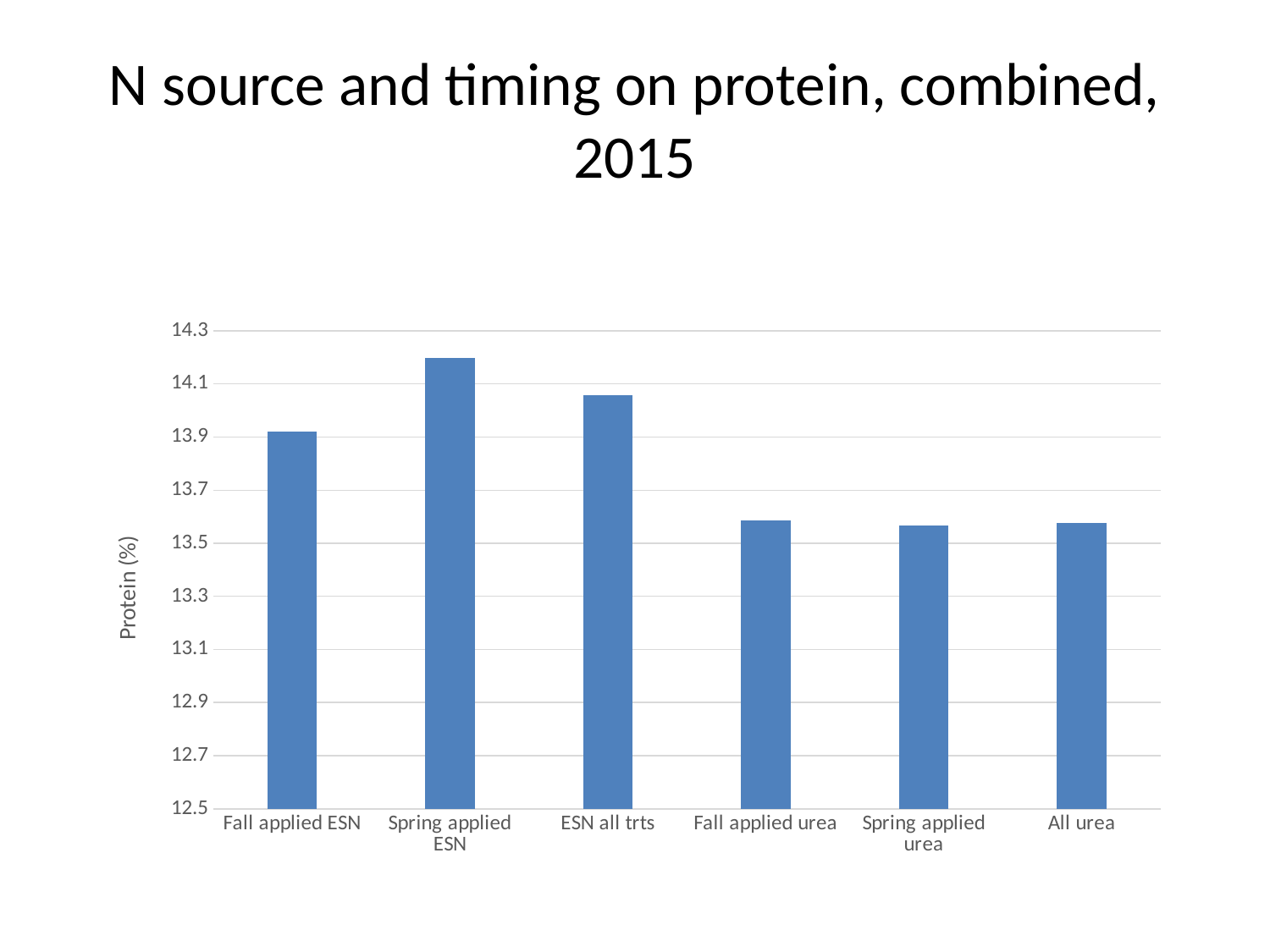
What is the title of the chart? N source and timing on protein, combined, 2015 Is the value for Fall applied ESN greater or less than 13.7? greater Is the value for Fall applied urea greater or less than 13.7? less Is the value for ESN all trts greater or less than 13.9? greater How many categories are plotted on the x axis? 6 What kind of chart is shown on the slide? bar chart What is the label on the vertical axis? Protein (%) Which category has the highest protein value? Spring applied ESN Which is larger, the value for ESN all trts or the value for Fall applied urea? ESN all trts Which is larger, the value for Spring applied ESN or the value for Fall applied ESN? Spring applied ESN